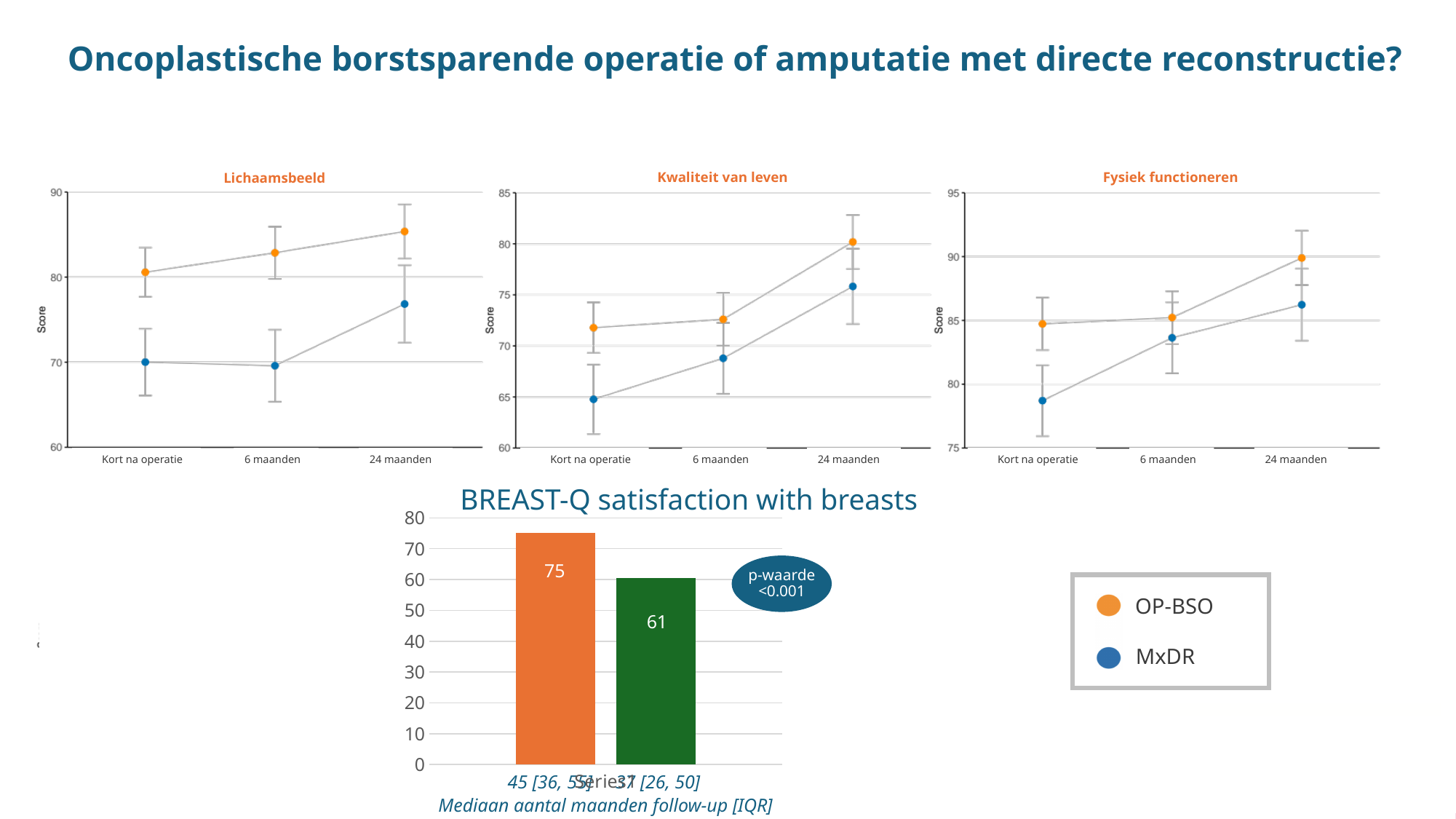
In the Fysiek functioneren chart, is the MxDR value at Kort na operatie greater or less than 80? less In the BREAST-Q satisfaction with breasts chart, which bar is higher, the orange or the green one? orange In the Lichaamsbeeld chart, is the MxDR value at 24 maanden greater or less than 80? less In the BREAST-Q satisfaction with breasts chart, what is the difference between the orange bar and the green bar? 14 How many time points are shown on the x axis of the Kwaliteit van leven chart? 3 What kind of chart is the BREAST-Q satisfaction with breasts chart? bar chart In the Lichaamsbeeld chart, is the OP-BSO value at 24 maanden greater or less than 80? greater How many series does the legend on the slide list? 2 In the Lichaamsbeeld chart, which series has the higher value at Kort na operatie, OP-BSO or MxDR? OP-BSO In the BREAST-Q satisfaction with breasts chart, what is the value of the green bar? 61 In the BREAST-Q satisfaction with breasts chart, what is the value of the orange bar? 75 What kind of chart is the Lichaamsbeeld chart? line chart